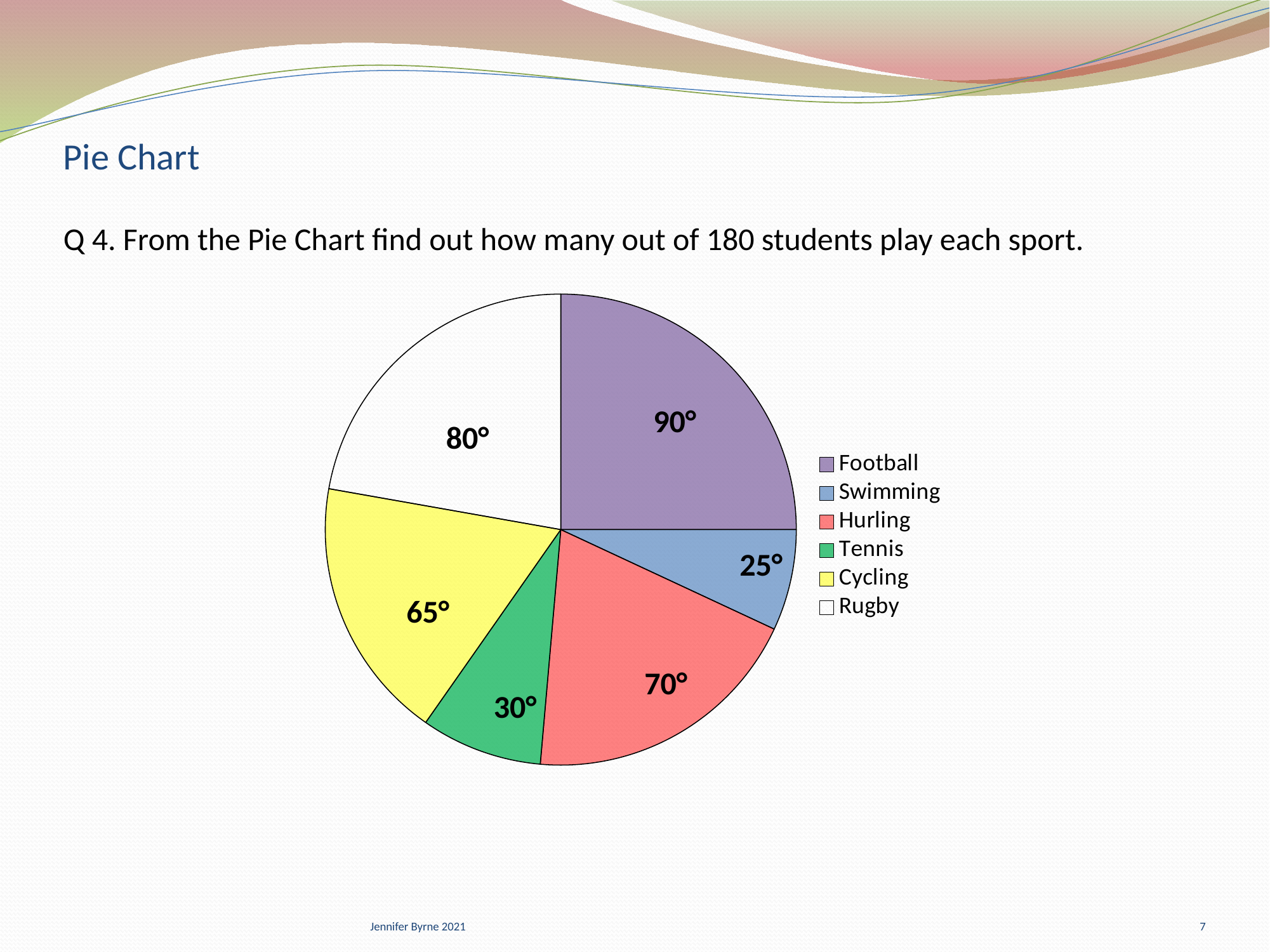
Which slice is larger, Hurling or Cycling? Hurling What is the angle of the Swimming slice? 25° Which sport has the smallest slice of the pie? Swimming Which sport has the largest slice of the pie? Football What is the angle of the Cycling slice? 65° What kind of chart is shown on the slide? pie chart What colour is the Cycling slice? yellow What is the angle of the Hurling slice? 70° What is the angle of the Football slice? 90° What share of the whole pie does the Football slice represent? 25% What is the difference in degrees between the Rugby slice and the Tennis slice? 50° How many sports are shown in the pie chart? 6